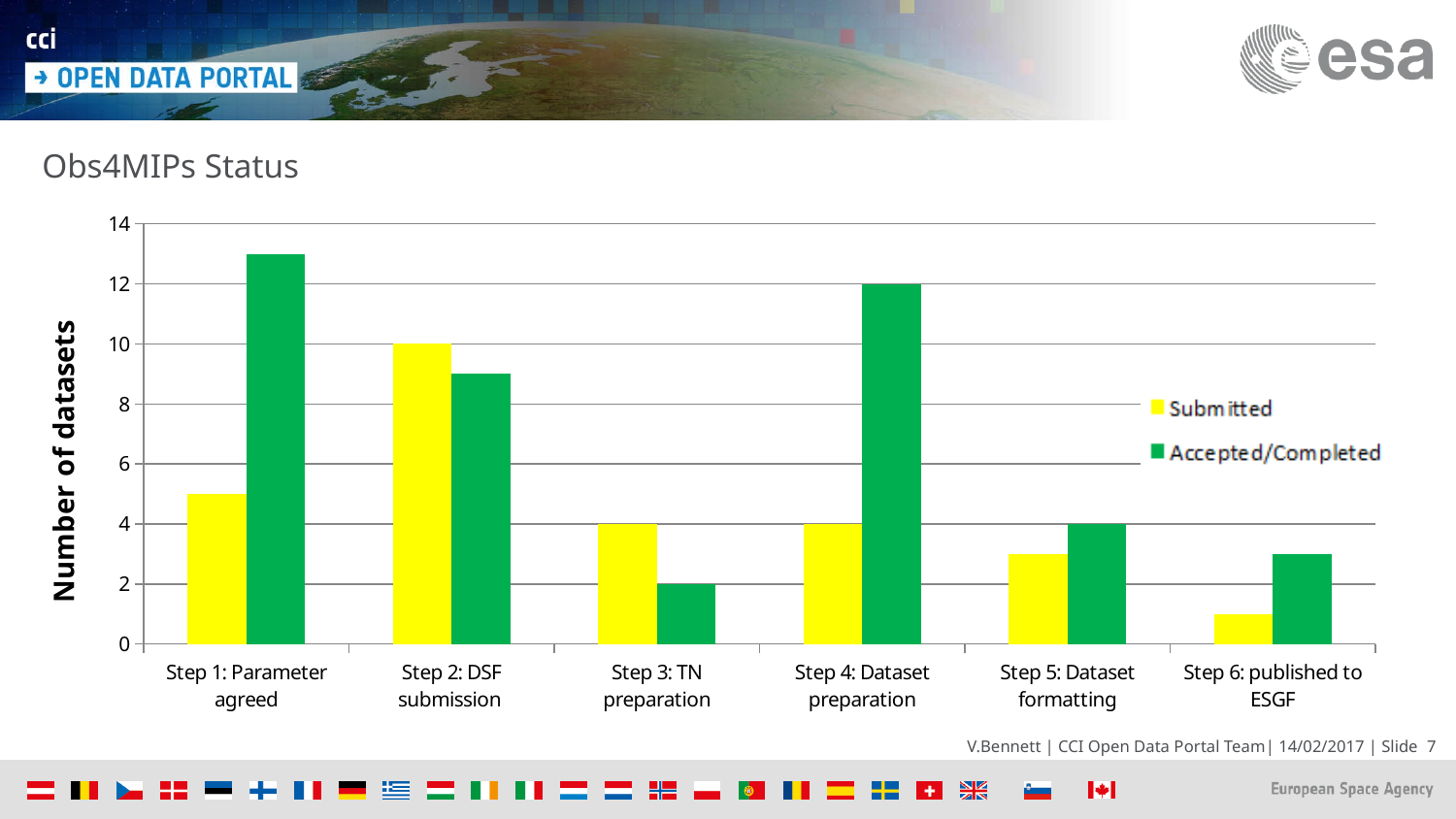
What type of chart is shown on the slide? bar chart What is the difference between the Accepted/Completed and Submitted values for Step 4: Dataset preparation? 8 How many series does the legend list? 2 Is the Accepted/Completed value for Step 1: Parameter agreed greater or less than 12? greater For Step 1: Parameter agreed, which is larger, Submitted or Accepted/Completed? Accepted/Completed What is the Submitted value for Step 2: DSF submission? 10 What is the Accepted/Completed value for Step 4: Dataset preparation? 12 Which step has the lowest Accepted/Completed value? Step 3: TN preparation Which step has the highest Submitted value? Step 2: DSF submission What is the Accepted/Completed value for Step 3: TN preparation? 2 What is the title of the y axis? Number of datasets How many steps (categories) are shown on the x axis? 6